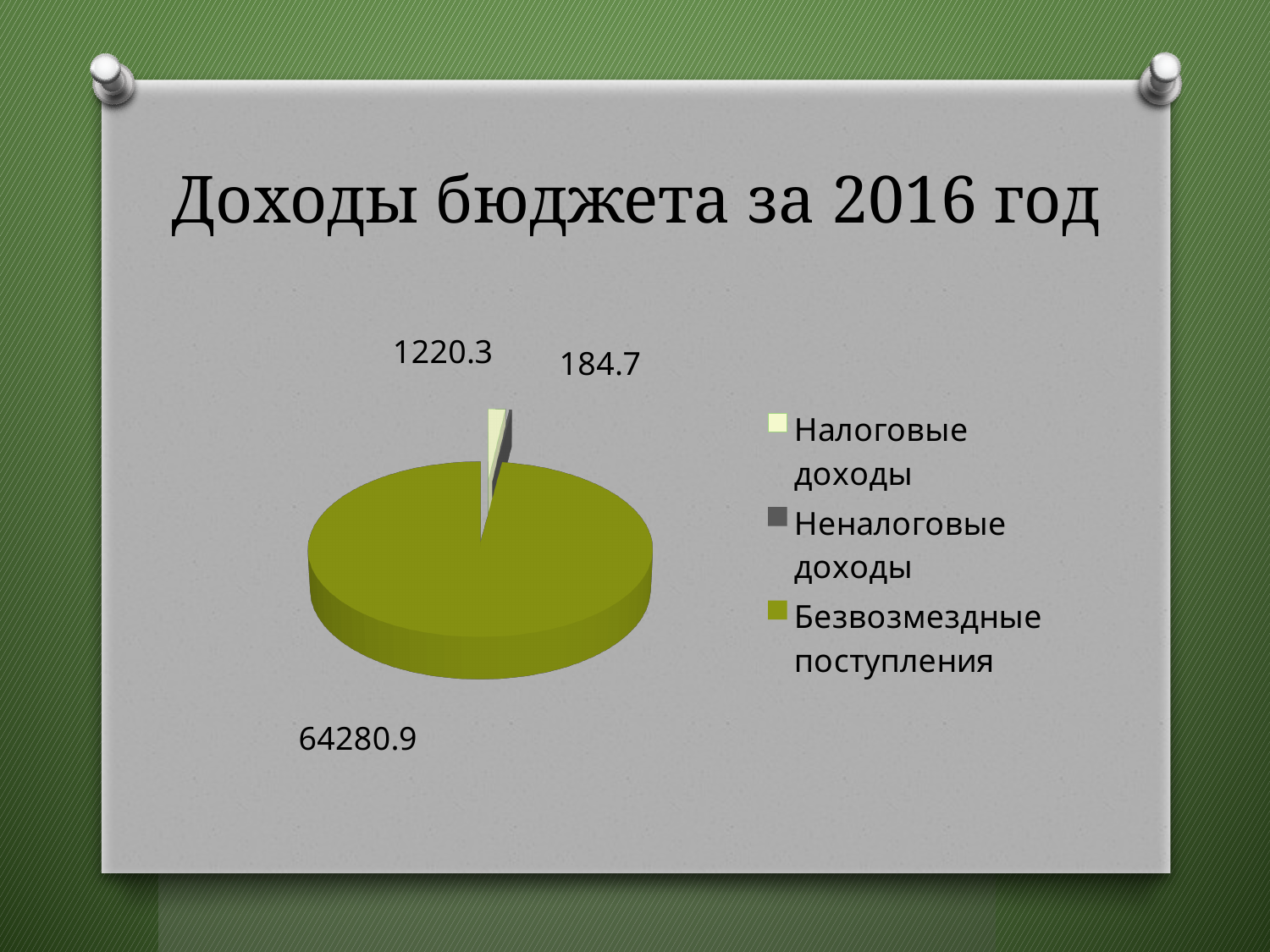
What is the difference between Налоговые доходы and Неналоговые доходы? 1035.6 What is the value for Налоговые доходы? 1220.3 What is the value for Безвозмездные поступления? 64280.9 Which category has the largest slice of the pie? Безвозмездные поступления What is the total of all three categories shown in the pie? 65685.9 What type of chart is shown on the slide? Pie chart Which is larger, Налоговые доходы or Неналоговые доходы? Налоговые доходы Which colour represents Безвозмездные поступления in the legend? Green Which category has the smallest slice of the pie? Неналоговые доходы How many categories does the legend list? 3 What is the title of the chart? Доходы бюджета за 2016 год What is the value for Неналоговые доходы? 184.7